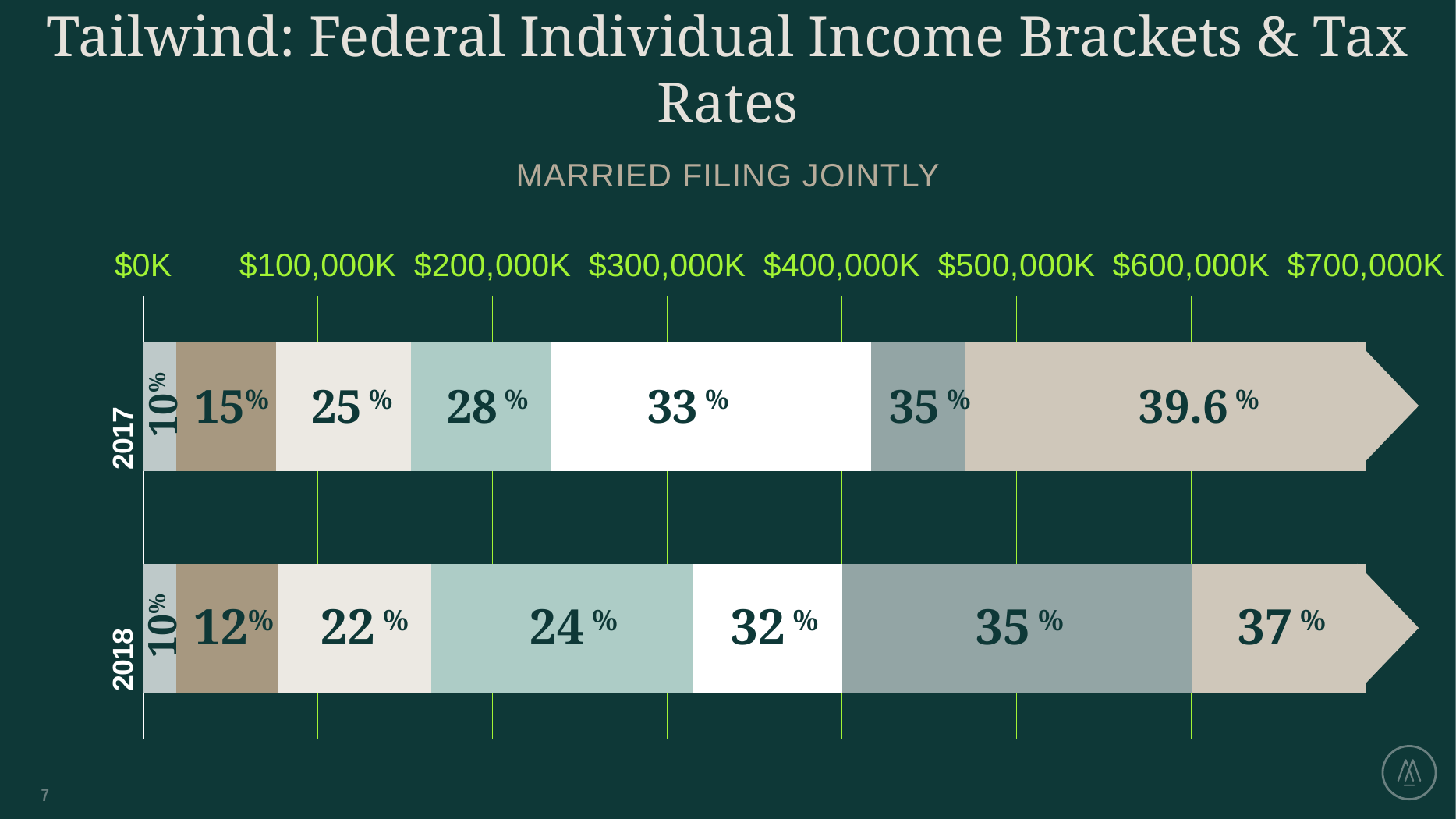
What is the fourth tax rate labelled on the 2017 bar? 28% What is the second tax rate labelled on the 2018 bar? 12% What is the highest tax rate labelled on the 2018 bar? 37% By how many percentage points does the 2017 top rate (39.6%) exceed the 2018 top rate (37%)? 2.6 What filing status does the chart's subtitle say it applies to? MARRIED FILING JOINTLY What is the lowest tax rate labelled on the 2018 bar? 10% What kind of chart is shown on the slide? Stacked horizontal bar chart How many tax bracket segments make up the 2017 bar? 7 How many years (bars) does the chart show? 2 Which year has the higher top tax rate, 2017 or 2018? 2017 What is the highest tax rate labelled on the 2017 bar? 39.6% Does the 2017 39.6% bracket begin at an income greater or less than $500,000K? less